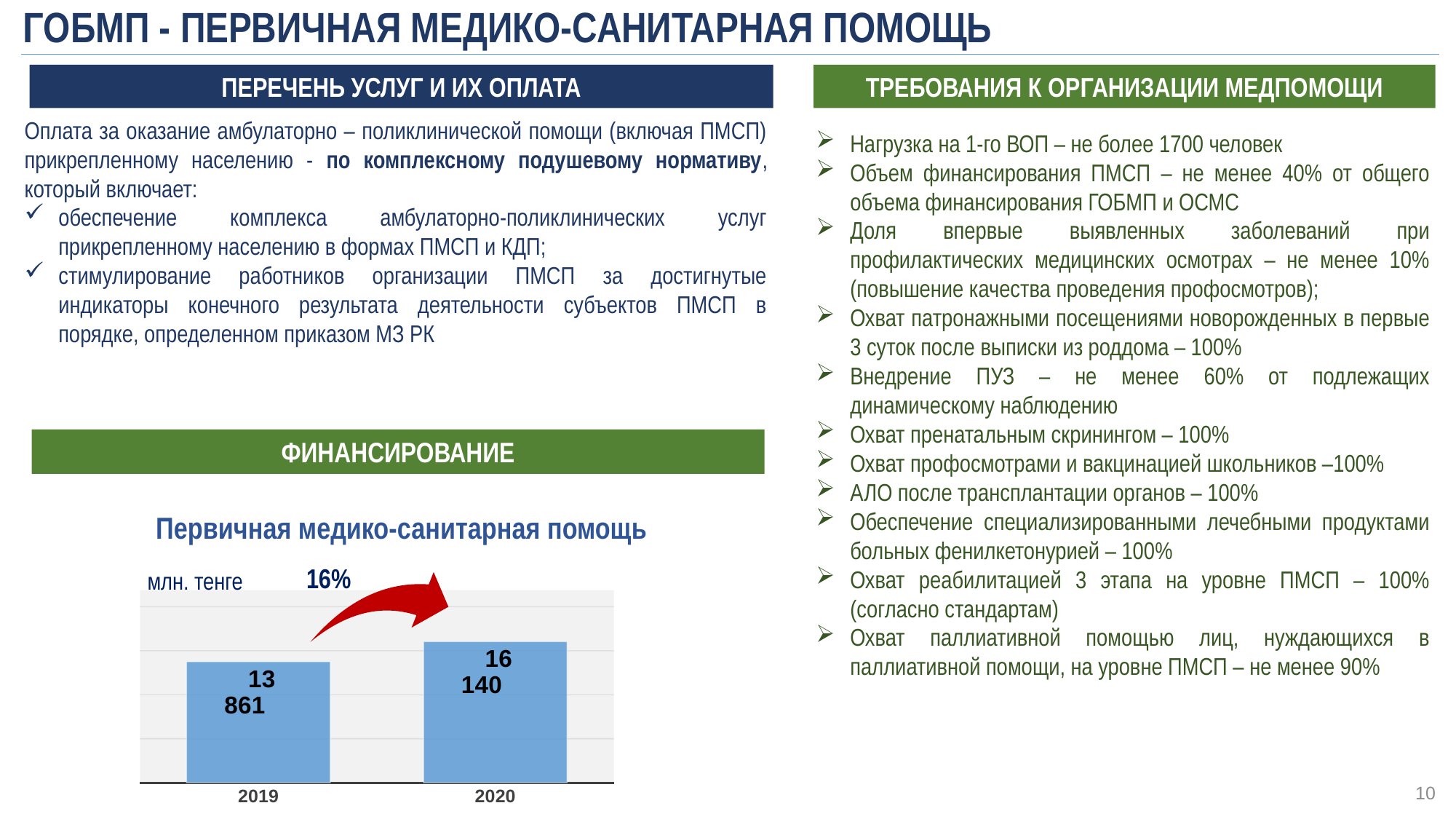
What kind of chart is 'Первичная медико-санитарная помощь'? bar chart Which year has the lower value in the chart 'Первичная медико-санитарная помощь'? 2019 What is the value for 2020 in the chart 'Первичная медико-санитарная помощь'? 16 140 Is the value for 2020 larger or smaller than the value for 2019 in the chart 'Первичная медико-санитарная помощь'? larger Do the values rise or fall from 2019 to 2020 in the chart 'Первичная медико-санитарная помощь'? rise What is the value for 2019 in the chart 'Первичная медико-санитарная помощь'? 13 861 What percentage growth is indicated by the arrow above the chart 'Первичная медико-санитарная помощь'? 16% Which year has the higher value in the chart 'Первичная медико-санитарная помощь'? 2020 How many years (categories) are shown in the chart 'Первичная медико-санитарная помощь'? 2 What is the difference between the 2020 and 2019 values in the chart 'Первичная медико-санитарная помощь'? 2 279 What unit of measurement is shown on the chart 'Первичная медико-санитарная помощь'? млн. тенге